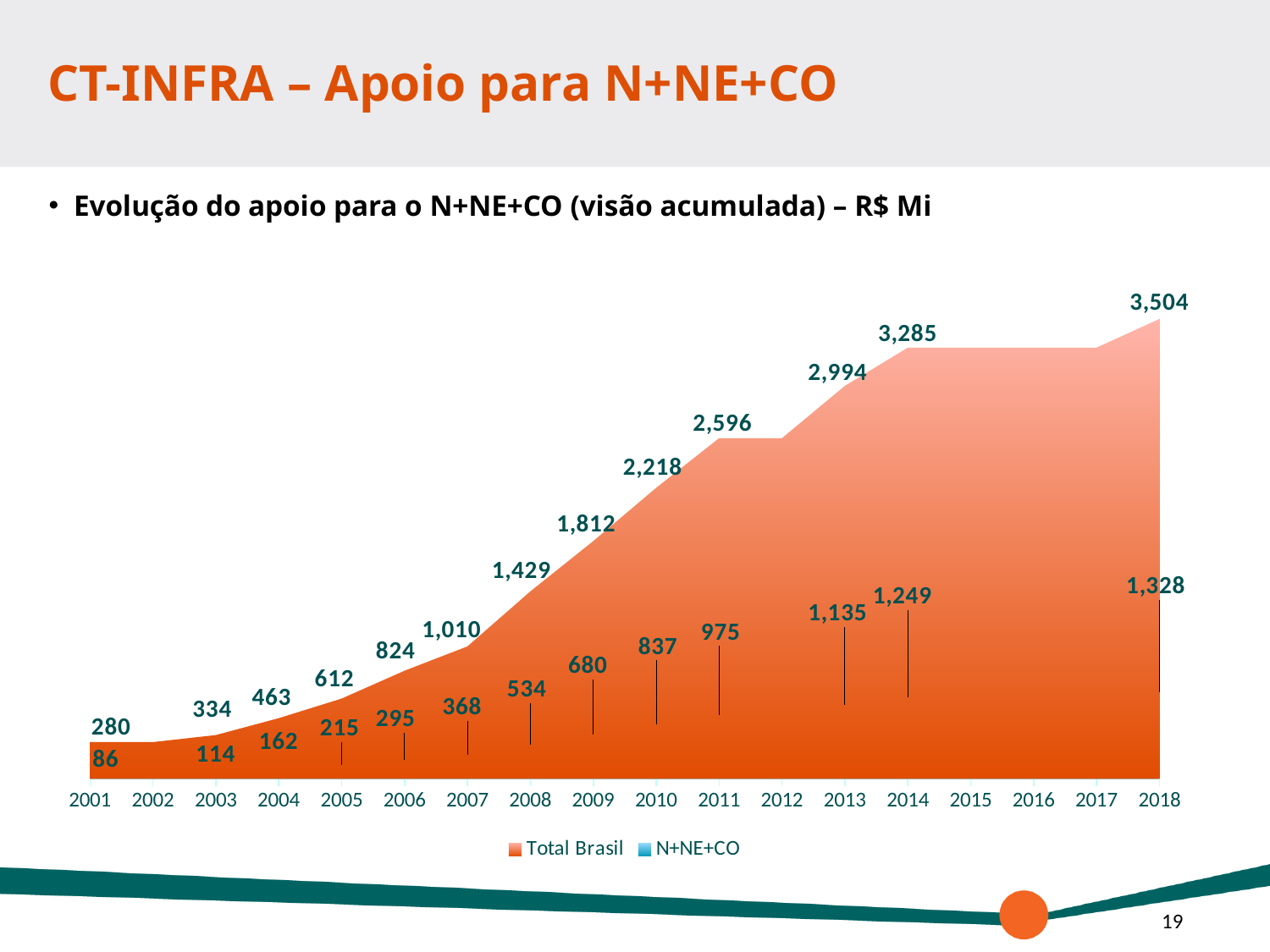
What type of chart is shown on the slide? area chart How many years are shown on the x axis? 18 How many series does the legend list? 2 What is the N+NE+CO value in 2018? 1,328 In which year does the Total Brasil series reach its highest value? 2018 Do the Total Brasil values rise or fall from 2001 to 2018? rise What is the difference between the Total Brasil and N+NE+CO values in 2018? 2,176 What is the Total Brasil value in 2018? 3,504 What is the N+NE+CO value in 2001? 86 What is the Total Brasil value in 2001? 280 What is the N+NE+CO value in 2009? 680 What are the two series named in the legend? Total Brasil and N+NE+CO